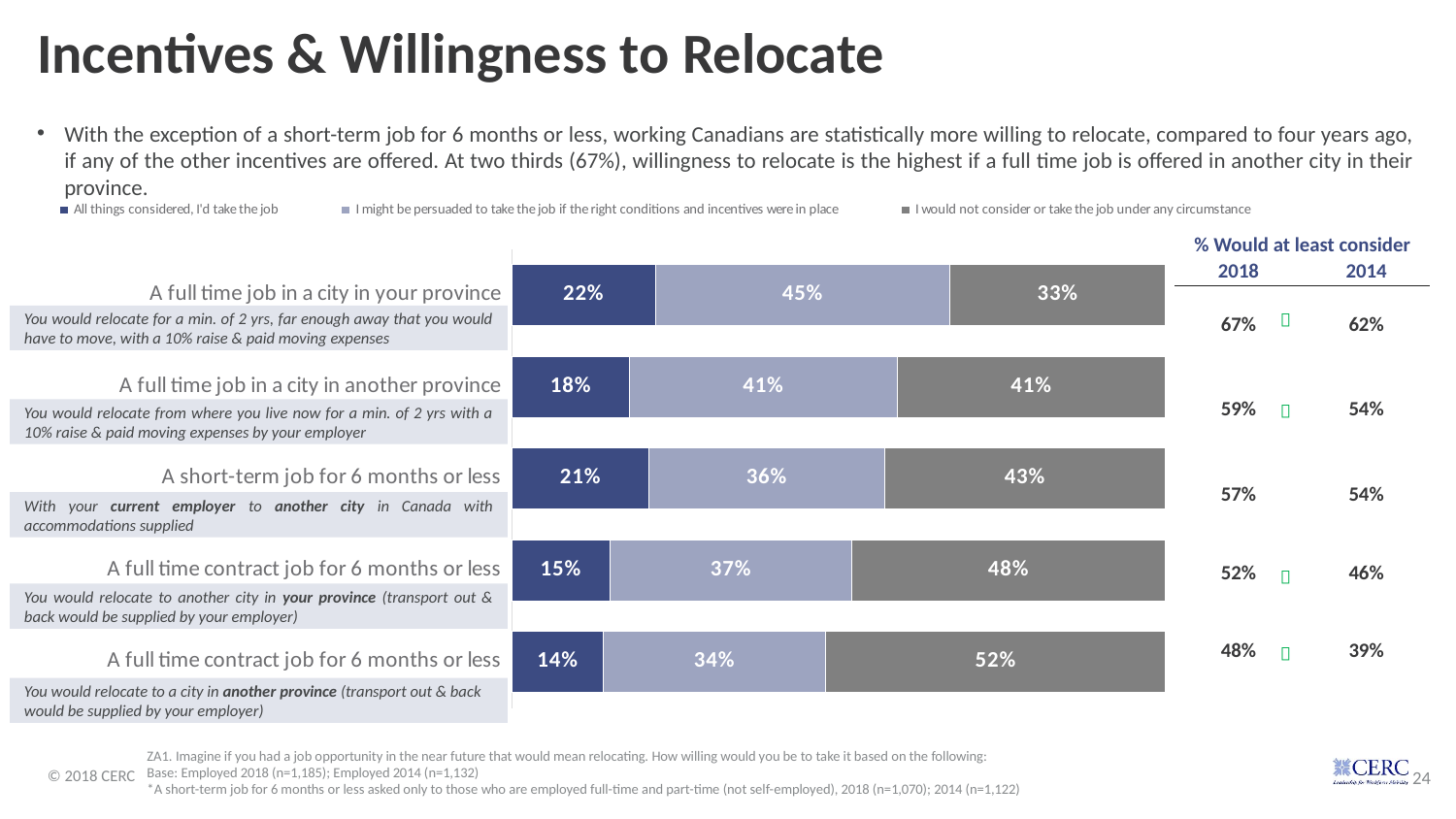
What percentage said "All things considered, I'd take the job" for a full time job in a city in your province? 22% What kind of chart is shown on the slide? Stacked bar chart How many job scenarios (bars) are plotted in the chart? 5 What percentage said "I might be persuaded to take the job if the right conditions and incentives were in place" for a short-term job for 6 months or less? 36% What percentage said "I would not consider or take the job under any circumstance" for a full time job in a city in another province? 41% In the "% Would at least consider" column, what is the 2018 value for a full time job in a city in your province? 67% Which job scenario has the highest percentage of "All things considered, I'd take the job"? A full time job in a city in your province For the bottom bar (a full time contract job for 6 months or less in another province), what percentage would not consider or take the job under any circumstance? 52% Which is larger: the "I might be persuaded" share for a full time job in a city in your province or for a full time job in a city in another province? A full time job in a city in your province Which job scenario has the lowest percentage of "All things considered, I'd take the job"? A full time contract job for 6 months or less (another province) What is the difference between the "I would not consider" percentages for the bottom bar (contract job, another province) and the top bar (full time job in your province)? 19 percentage points How many series does the chart legend list? 3